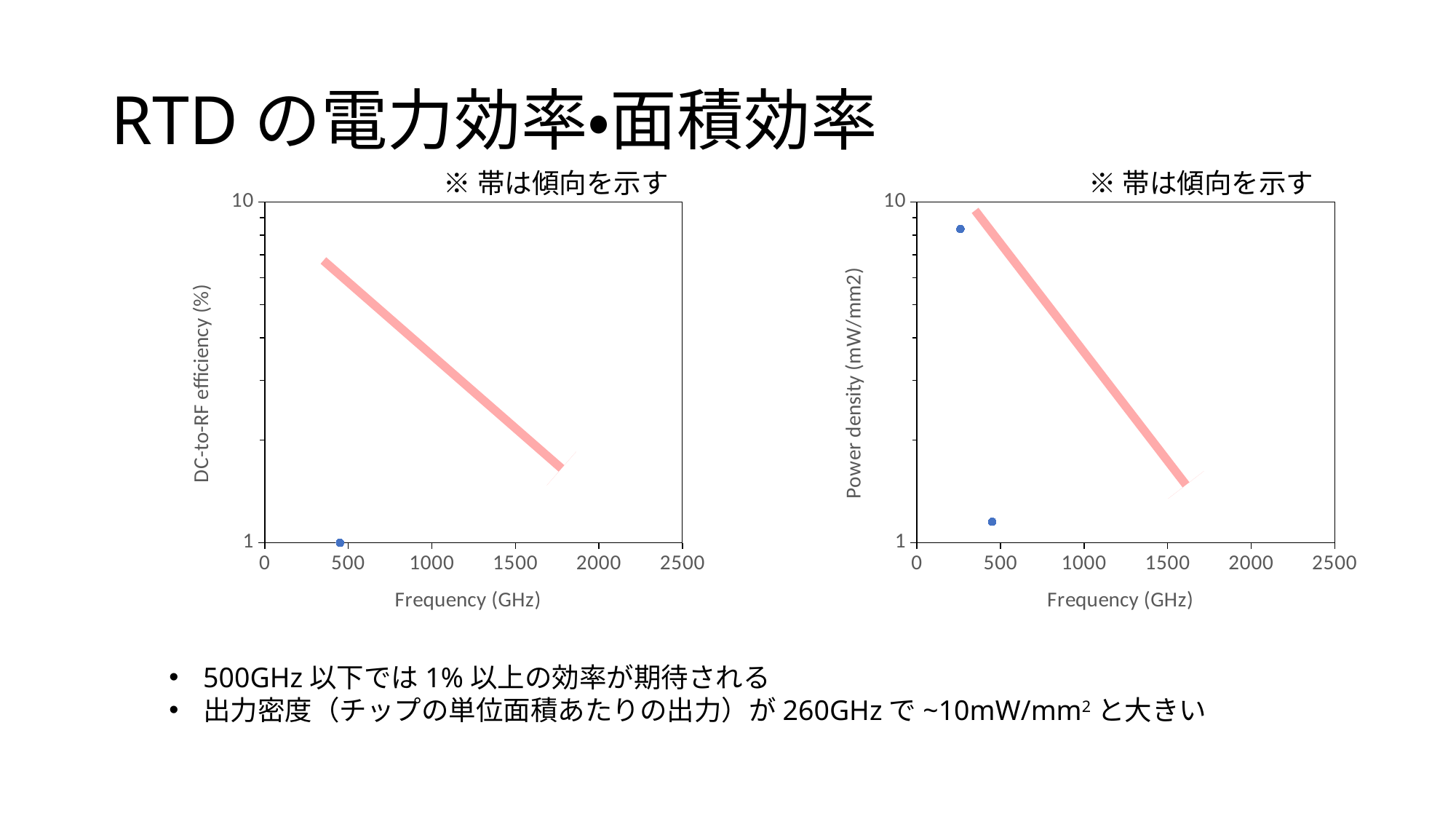
On the left chart, what is the label of the y axis? DC-to-RF efficiency (%) What kind of chart is the left chart (DC-to-RF efficiency vs Frequency)? scatter chart What is the highest frequency tick shown on the x axis of the right chart? 2500 How many data points are plotted on the left chart (DC-to-RF efficiency)? 1 On the left chart, does the pink trend band rise or fall as frequency increases? fall On the right chart, is the power density of the data point near 250 GHz greater or less than 1 mW/mm2? greater On the left chart, is the frequency of the plotted data point greater or less than 500 GHz? less How many data points are plotted on the right chart (Power density)? 2 What kind of chart is the right chart (Power density vs Frequency)? scatter chart On the right chart, does the pink trend band rise or fall as frequency increases? fall On the right chart, what is the label of the y axis? Power density (mW/mm2) On the right chart, which data point has the higher power density, the one near 250 GHz or the one near 450 GHz? the one near 250 GHz